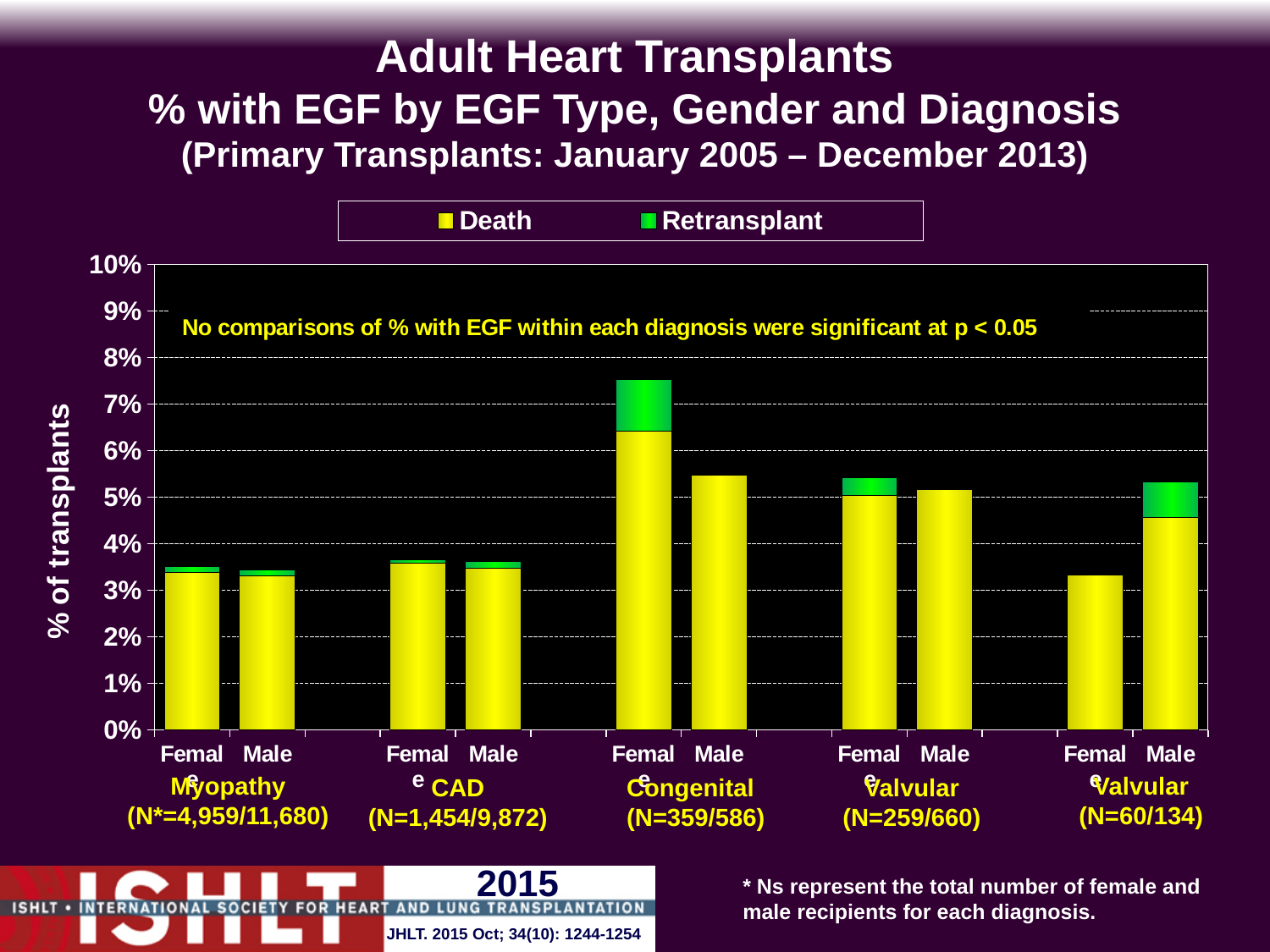
In the rightmost group (N=60/134), which is larger, the Female bar or the Male bar? Male Which is larger, the total for Congenital Female or Congenital Male? Congenital Female What kind of chart is shown on the slide? bar chart How many series does the legend list? 2 How many bars are plotted in the chart? 10 Which bar has the highest total % with EGF? Congenital Female Is the total value for Female in the rightmost group (N=60/134) greater or less than 4%? less What are the two series named in the legend? Death and Retransplant Is the total value for Congenital Male greater or less than 5%? greater What is the label on the y axis? % of transplants Is the total value for Myopathy Female greater or less than 4%? less